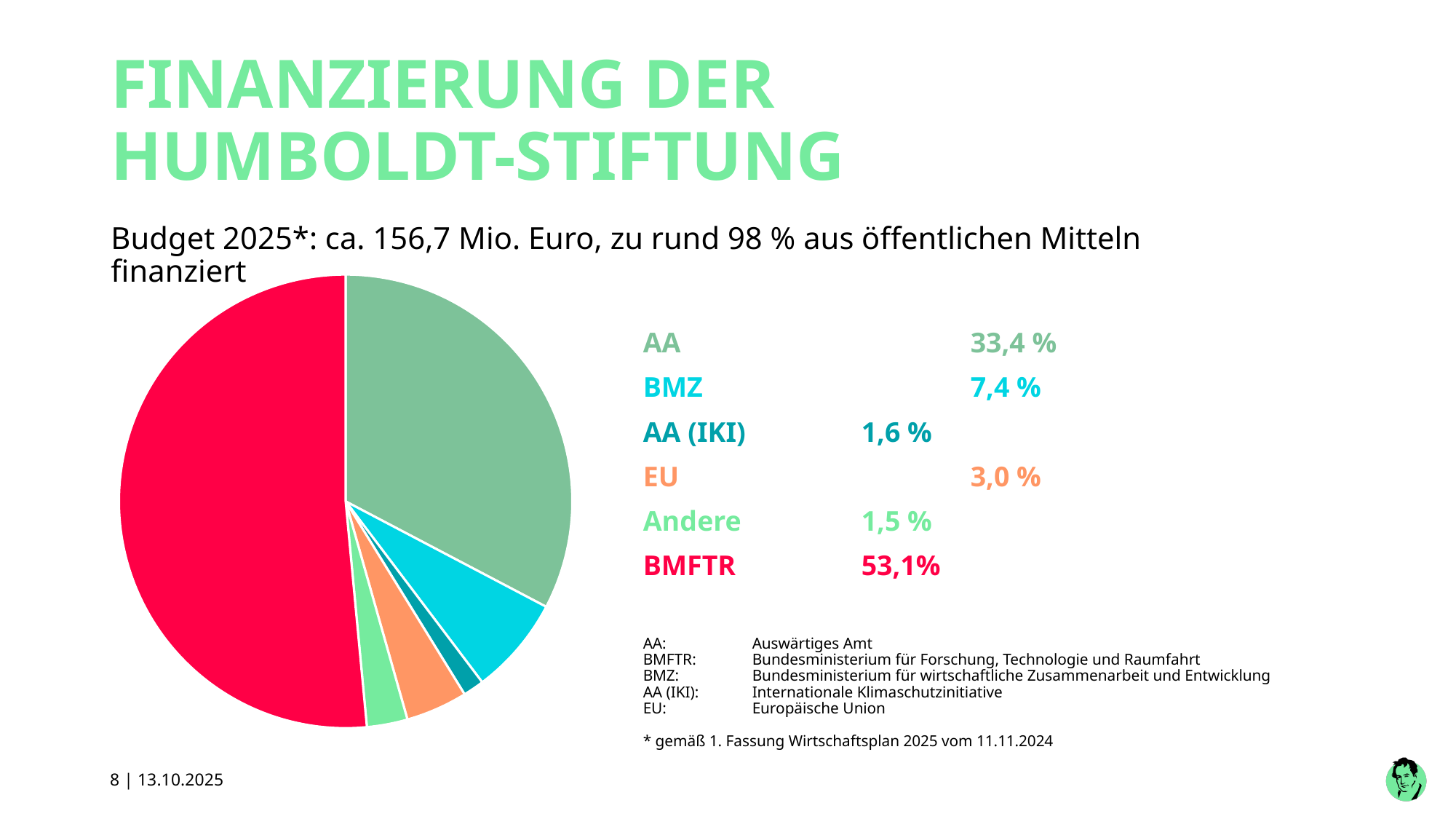
Which is larger, the share for BMZ or the share for EU? BMZ What kind of chart is shown on the slide? pie chart What percentage is shown for AA? 33,4 % What is the difference in percentage points between the BMFTR share and the AA share? 19,7 Which funding source has the smallest share? Andere How many slices does the pie chart have? 6 What share of the Humboldt-Stiftung funding comes from BMFTR? 53,1% Which funding source has the largest slice of the pie? BMFTR What percentage is shown for EU? 3,0 % What percentage is shown for AA (IKI)? 1,6 % What colour is the BMFTR slice in the pie chart? red What percentage is shown for BMZ? 7,4 %